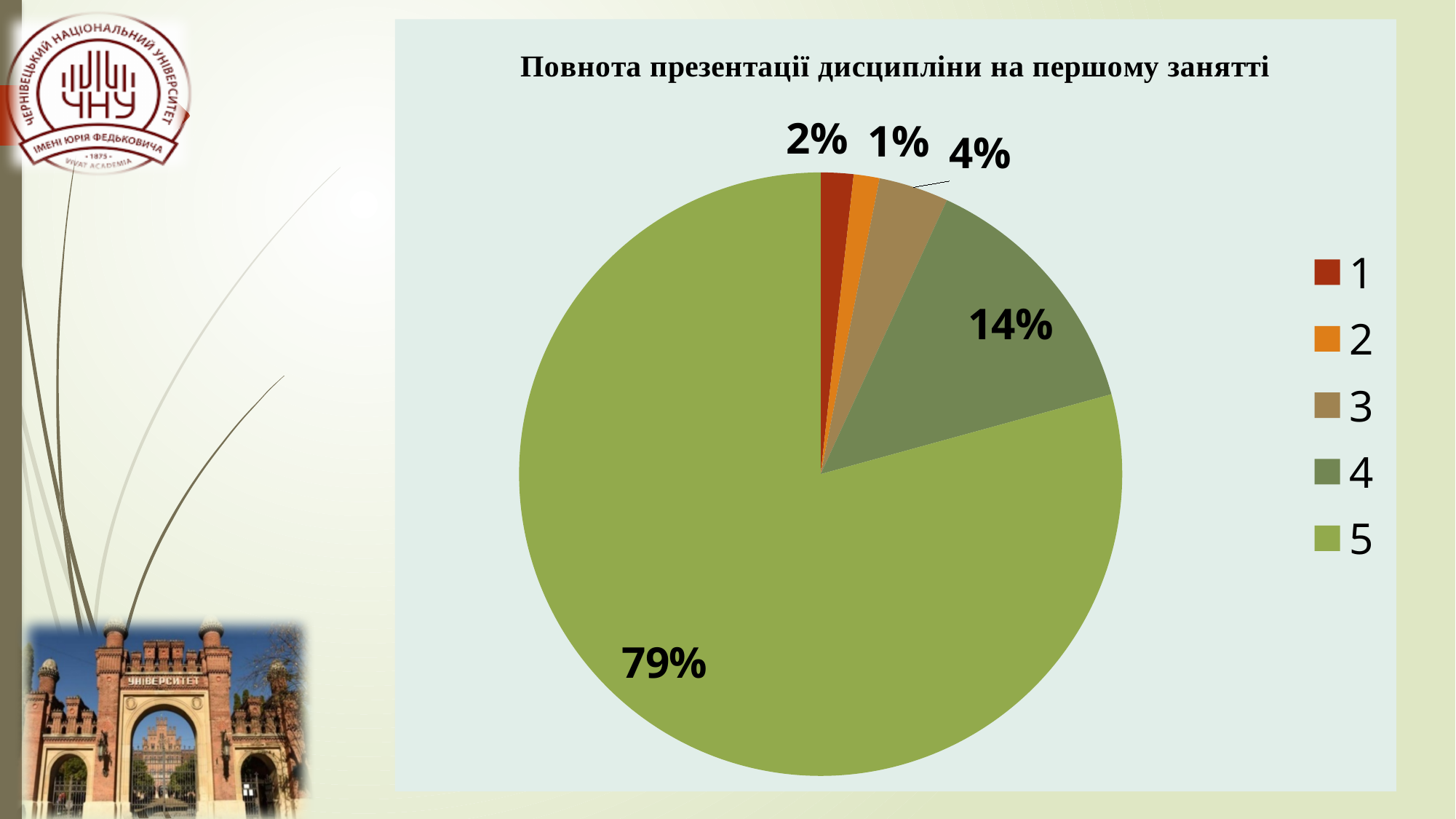
What share of the pie does category 2 have? 1% How many categories does the pie chart have? 5 What share of the pie does category 5 have? 79% What is the difference between the shares of category 5 and category 4? 65% Which category has the largest slice of the pie? 5 Which is larger, the share of category 3 or the share of category 1? 3 What kind of chart is shown on the slide? pie chart What share of the pie does category 3 have? 4% Which category has the smallest slice of the pie? 2 What is the title of the chart? Повнота презентації дисципліни на першому занятті